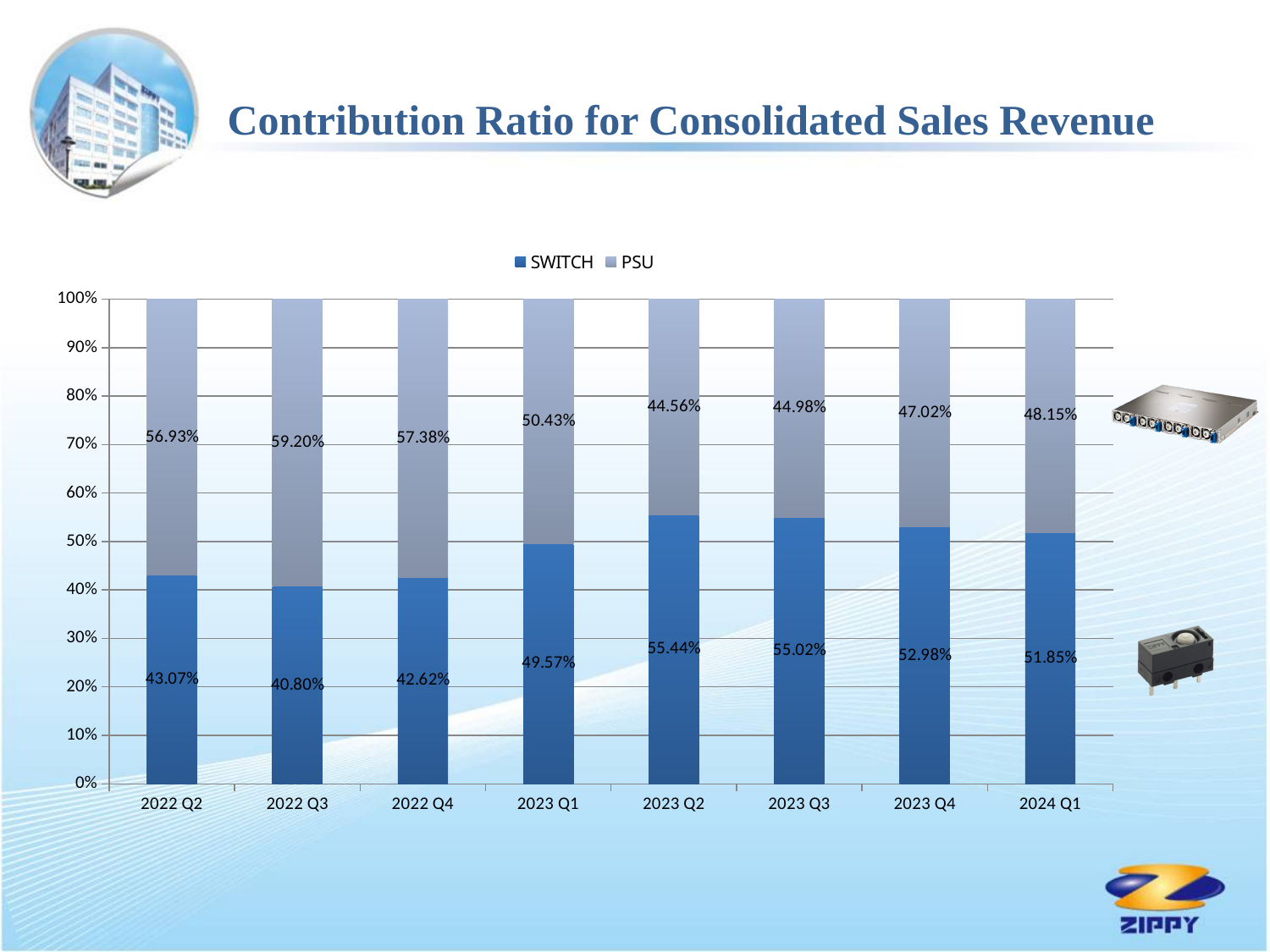
How many quarters are shown on the x axis? 8 How many series does the legend list? 2 What is the difference between the PSU and SWITCH contribution ratios in 2022 Q2? 13.86% Which is larger in 2023 Q4, the SWITCH ratio or the PSU ratio? SWITCH What is the SWITCH contribution ratio for 2024 Q1? 51.85% In which quarter is the SWITCH contribution ratio highest? 2023 Q2 In which quarter is the SWITCH contribution ratio lowest? 2022 Q3 What is the PSU contribution ratio for 2022 Q3? 59.20% What is the SWITCH contribution ratio for 2023 Q2? 55.44% What is the title of the chart on the slide? Contribution Ratio for Consolidated Sales Revenue In which quarter is the PSU contribution ratio highest? 2022 Q3 What kind of chart is shown on the slide? Stacked bar chart